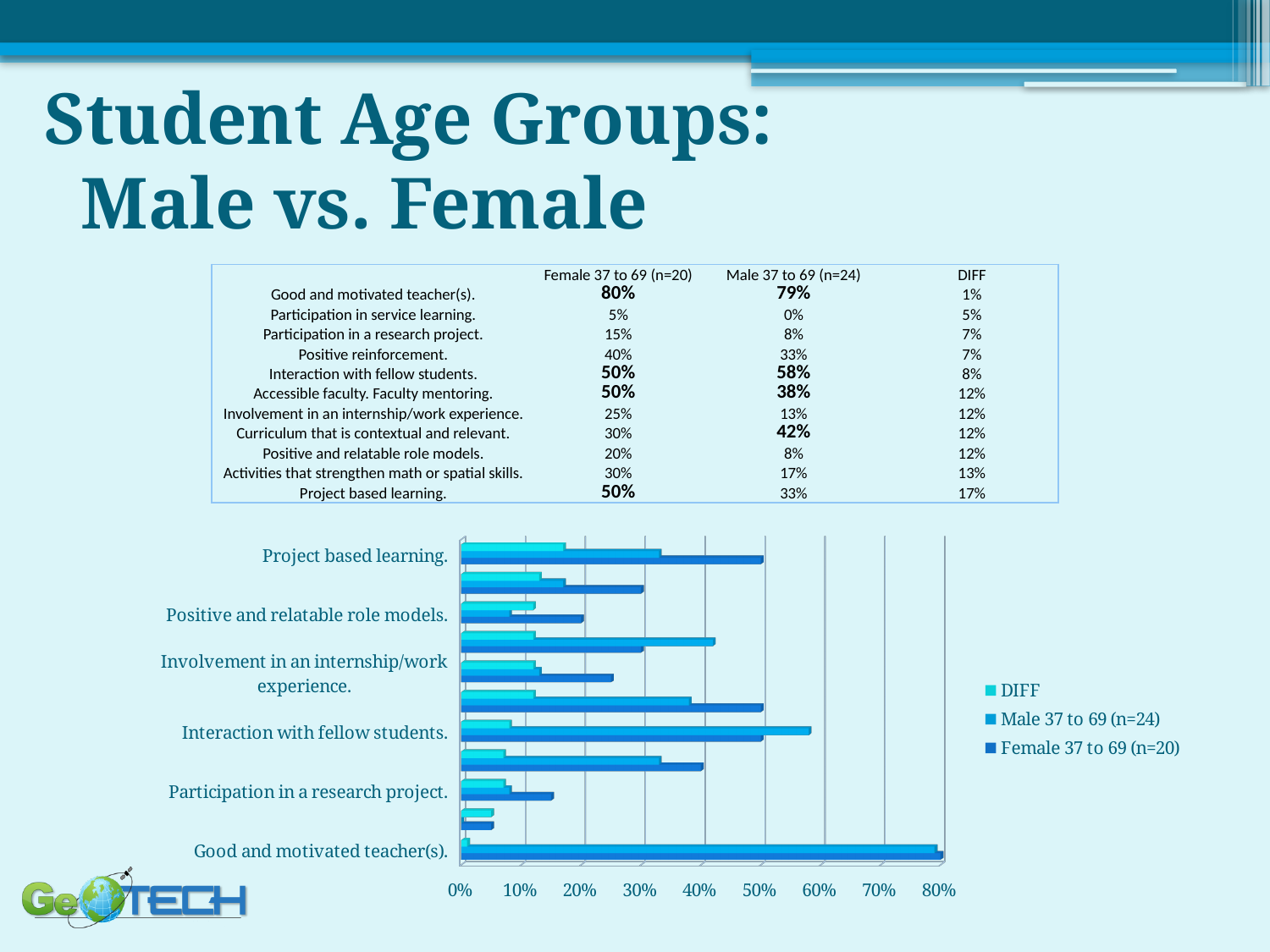
How many series does the chart legend list? 3 What is the value for Female 37 to 69 (n=20) for Good and motivated teacher(s)? 80% How many categories are plotted in the chart? 11 What is the difference between the Female 37 to 69 (n=20) and Male 37 to 69 (n=24) values for Accessible faculty. Faculty mentoring? 12% For Curriculum that is contextual and relevant, which is larger: the Female 37 to 69 (n=20) value or the Male 37 to 69 (n=24) value? Male 37 to 69 (n=24) What is the DIFF value for Project based learning? 17% Is the Female 37 to 69 (n=20) value for Project based learning greater or less than 40%? greater Which category has the highest value for Female 37 to 69 (n=20)? Good and motivated teacher(s). What is the value for Male 37 to 69 (n=24) for Interaction with fellow students? 58% What kind of chart is shown on the slide? bar chart Which legend entry is shown in the lightest blue colour? DIFF Which category has the lowest value for Male 37 to 69 (n=24)? Participation in service learning.